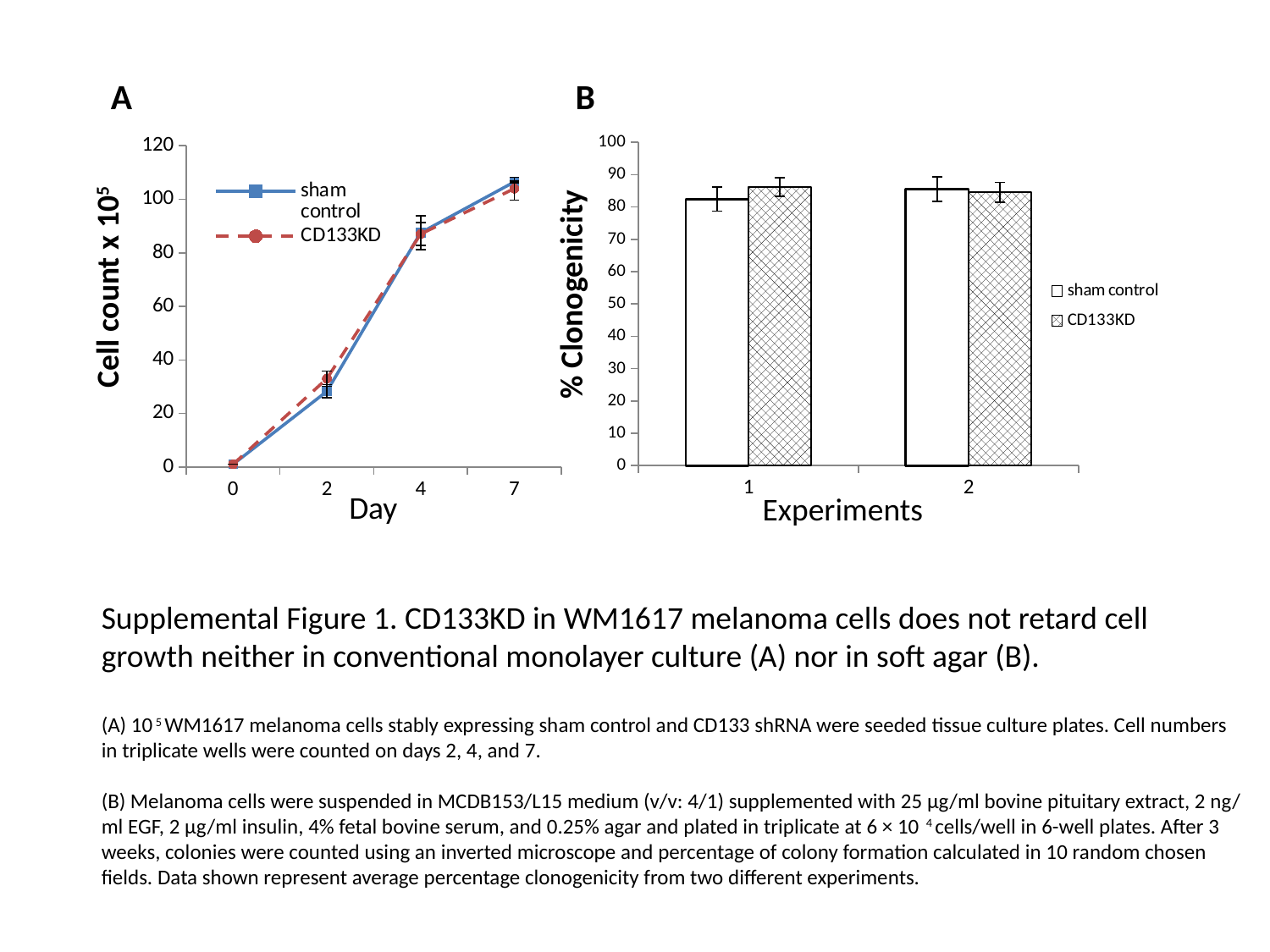
In chart A, does the cell count rise or fall from day 0 to day 7? rise In chart B, is the % clonogenicity for CD133KD in experiment 2 greater or less than 90? less What kind of chart is chart A? line chart What kind of chart is chart B? bar chart In chart B, how many experiments are shown on the x axis? 2 What is the y-axis label of chart B? % Clonogenicity In chart A, how many day points are plotted along the x axis? 4 How many series does the legend of chart A list? 2 How many series does the legend of chart B list? 2 In chart B, is the % clonogenicity for sham control in experiment 1 greater or less than 70? greater In chart A, is the sham control cell count at day 4 greater or less than 80? greater